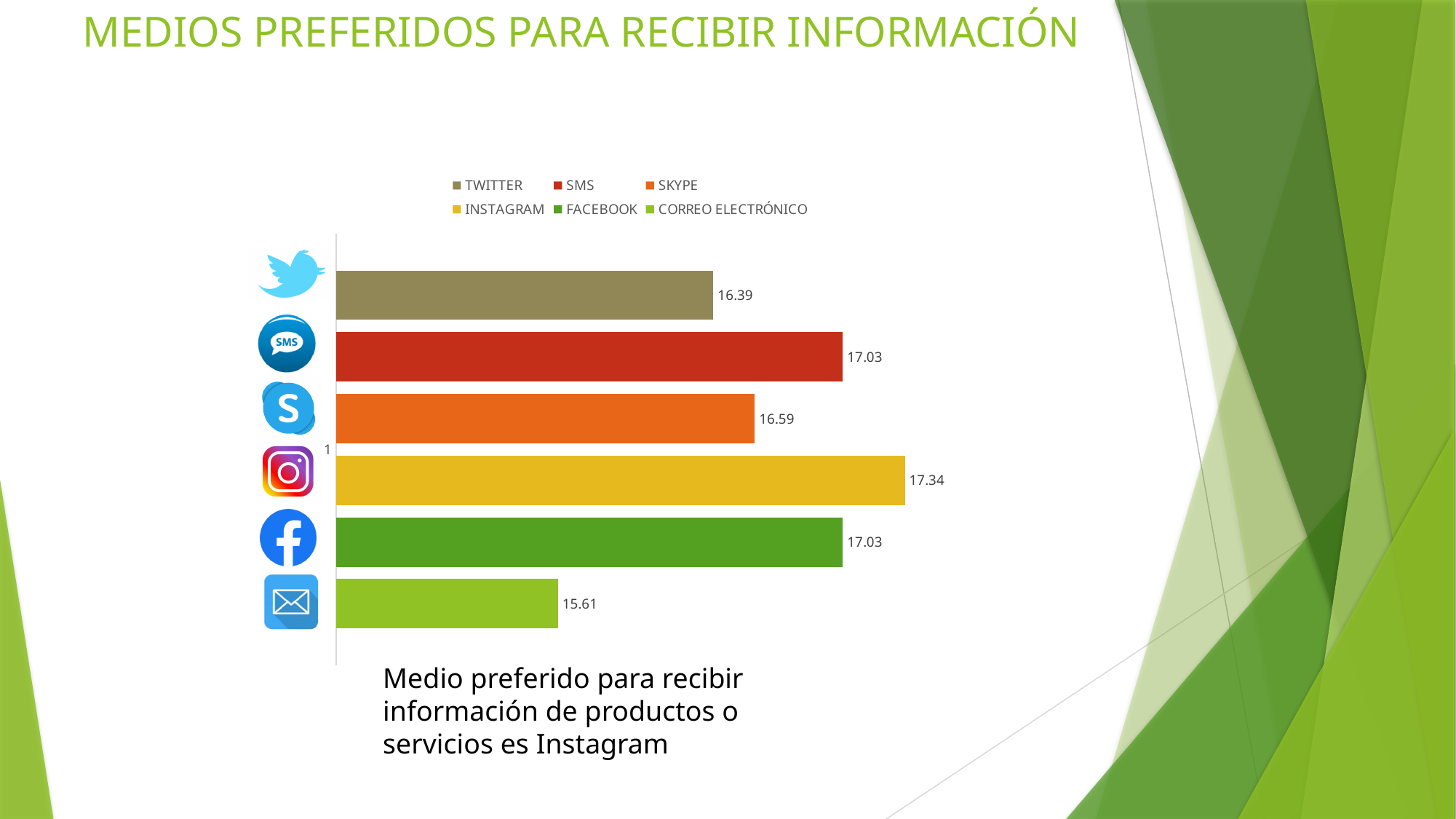
What is the value for SKYPE? 16.59 What is the value for TWITTER? 16.39 Which is larger, the value for SKYPE or the value for TWITTER? SKYPE What is the title of the slide? MEDIOS PREFERIDOS PARA RECIBIR INFORMACIÓN What is the value for CORREO ELECTRÓNICO? 15.61 What is the value for INSTAGRAM? 17.34 How many series does the legend list? 6 What kind of chart is shown on the slide? Bar chart Which series has the lowest value? CORREO ELECTRÓNICO Which series has the highest value? INSTAGRAM What is the difference between the values for INSTAGRAM and CORREO ELECTRÓNICO? 1.73 What is the difference between the values for SMS and TWITTER? 0.64